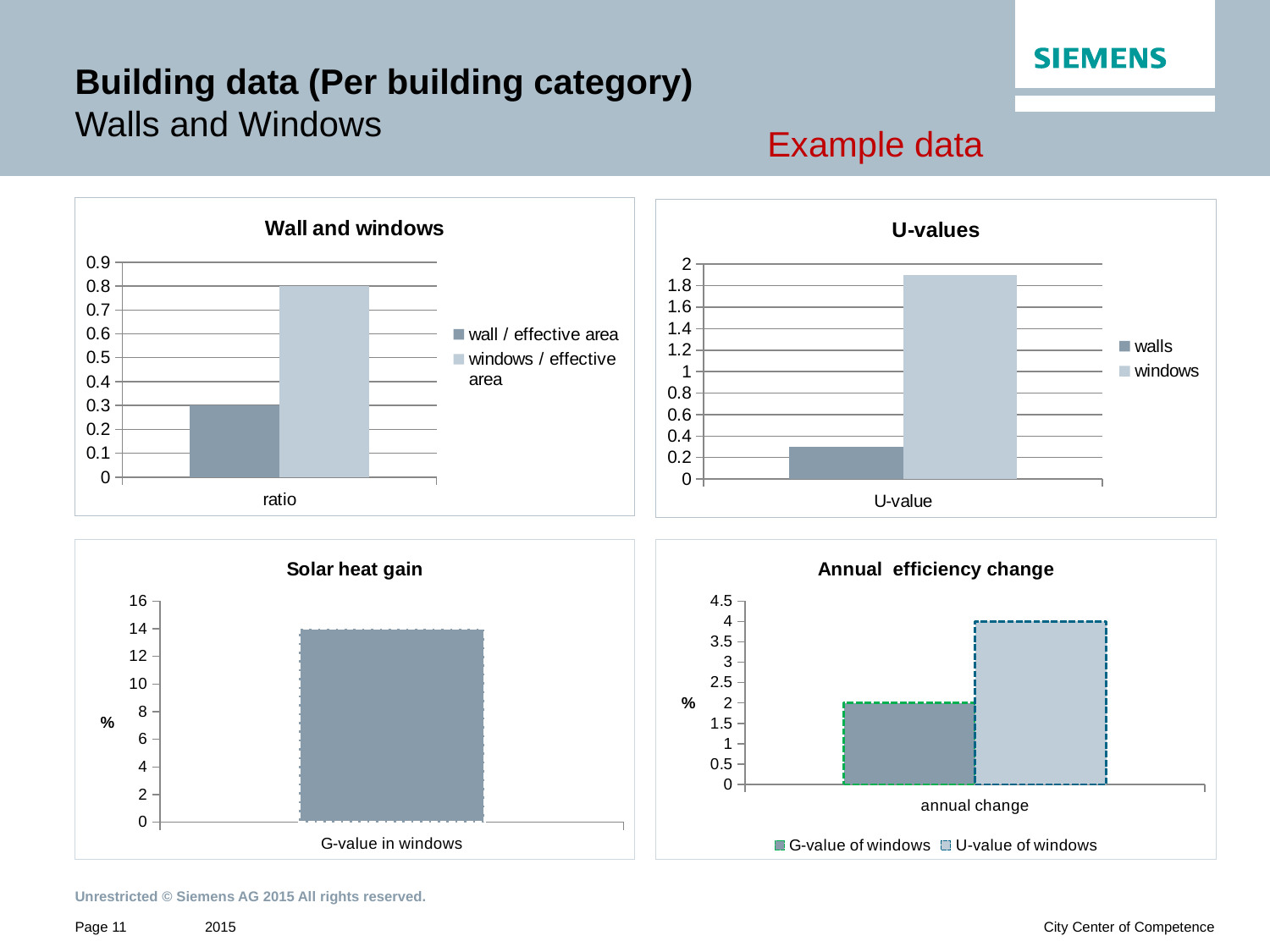
In the 'Annual efficiency change' chart, what is the value for U-value of windows? 4 In the 'U-values' chart, which series has the higher value, walls or windows? windows In the 'Annual efficiency change' chart, what is the difference between the U-value of windows and the G-value of windows? 2 In the 'Wall and windows' chart, what is the value for windows / effective area? 0.8 In the 'Wall and windows' chart, what is the difference between the windows / effective area and wall / effective area values? 0.5 In the 'U-values' chart, is the value for windows greater or less than 1.8? greater In the 'Wall and windows' chart, how many series does the legend list? 2 In the 'U-values' chart, is the value for walls greater or less than 0.4? less What kind of chart is the 'Solar heat gain' chart? bar chart In the 'Solar heat gain' chart, what is the value for G-value in windows? 14 What is the title of the chart in the bottom-right of the slide? Annual efficiency change In the 'Wall and windows' chart, what is the value for wall / effective area? 0.3